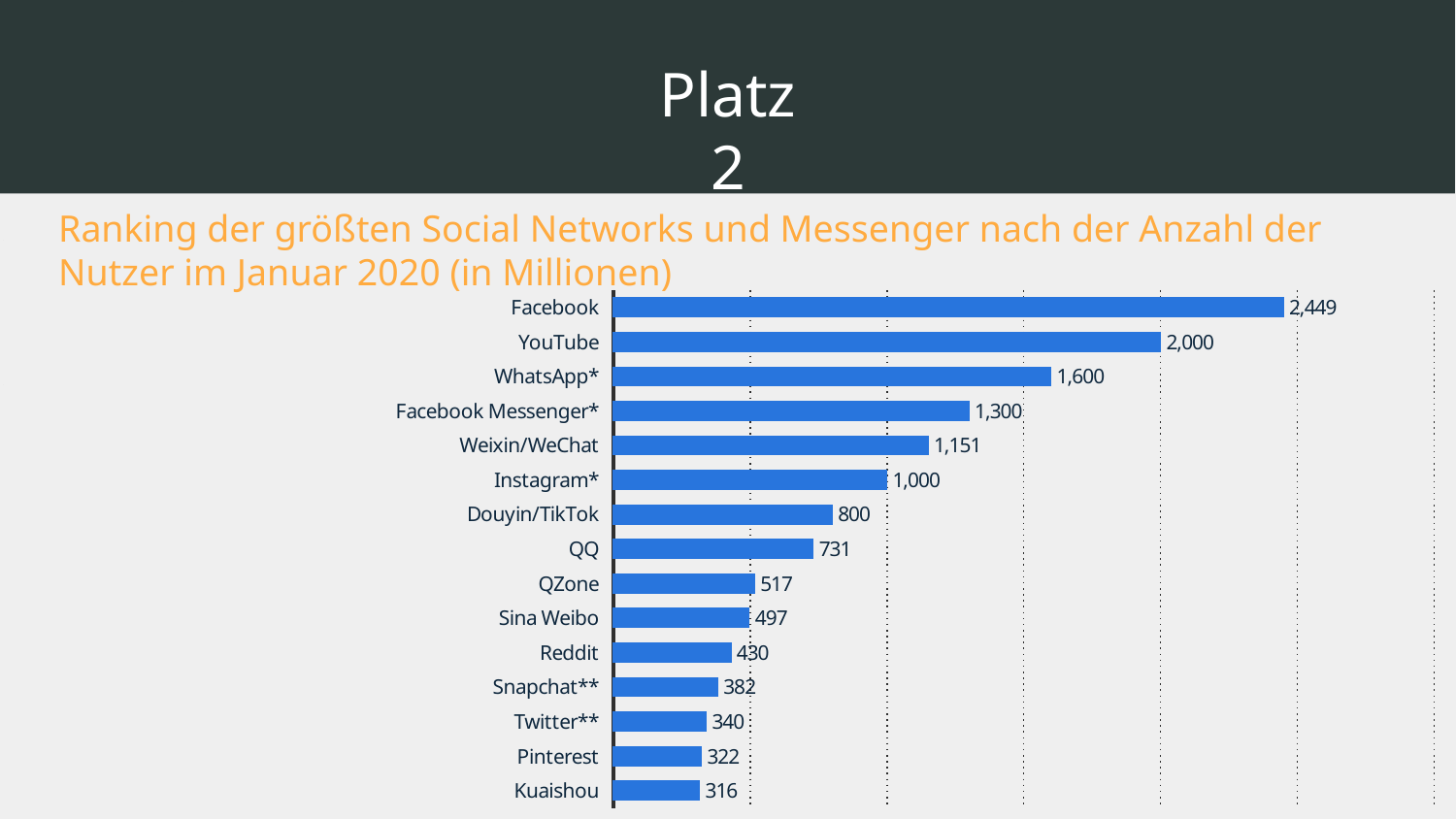
Which is larger, the value for Reddit or the value for Snapchat**? Reddit What is the difference between the values for YouTube and WhatsApp*? 400 What kind of chart is shown on the slide? Bar chart Which category has the lowest value? Kuaishou What is the value for Pinterest? 322 What is the title of the chart? Ranking der größten Social Networks und Messenger nach der Anzahl der Nutzer im Januar 2020 (in Millionen) What is the value for Weixin/WeChat? 1,151 What is the value for Facebook? 2,449 Which category has the highest value? Facebook What is the value for Sina Weibo? 497 What is the difference between the values for Douyin/TikTok and QQ? 69 How many categories are shown in the chart? 15